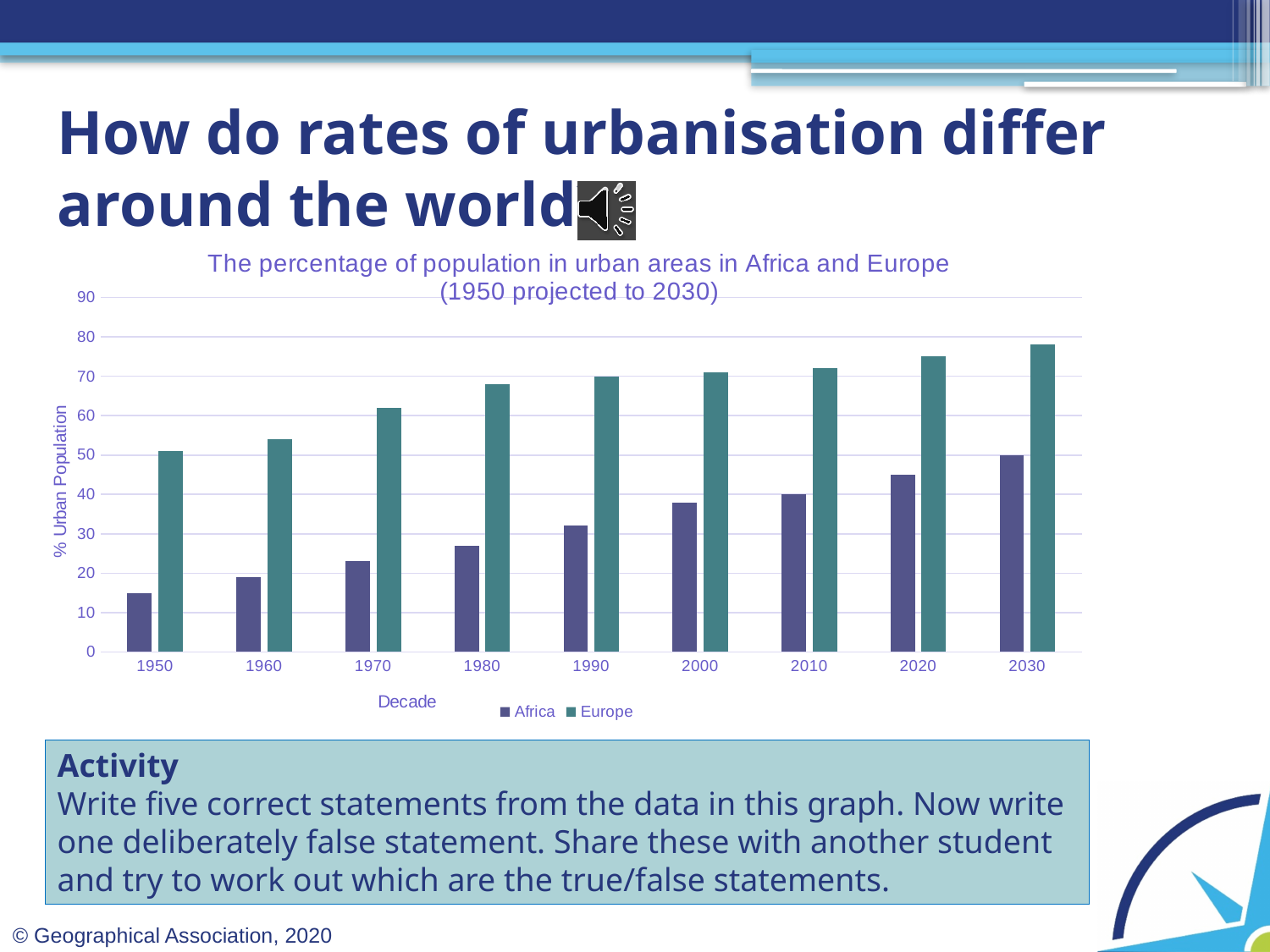
In which decade is the Europe bar highest? 2030 How many series does the legend list? 2 Is the value for Africa in 1950 greater or less than 20? less Is the value for Europe in 1970 greater or less than 60? greater What kind of chart is shown on the slide? Bar chart Which series is shown in green in the legend? Europe How many decades are shown along the x axis? 9 What is the label on the y axis? % Urban Population Do the Africa values rise or fall from 1950 to 2030? Rise Is the value for Europe in 2030 greater or less than 70? greater In 1950, which is larger: the value for Africa or the value for Europe? Europe In which decade is the Africa bar lowest? 1950